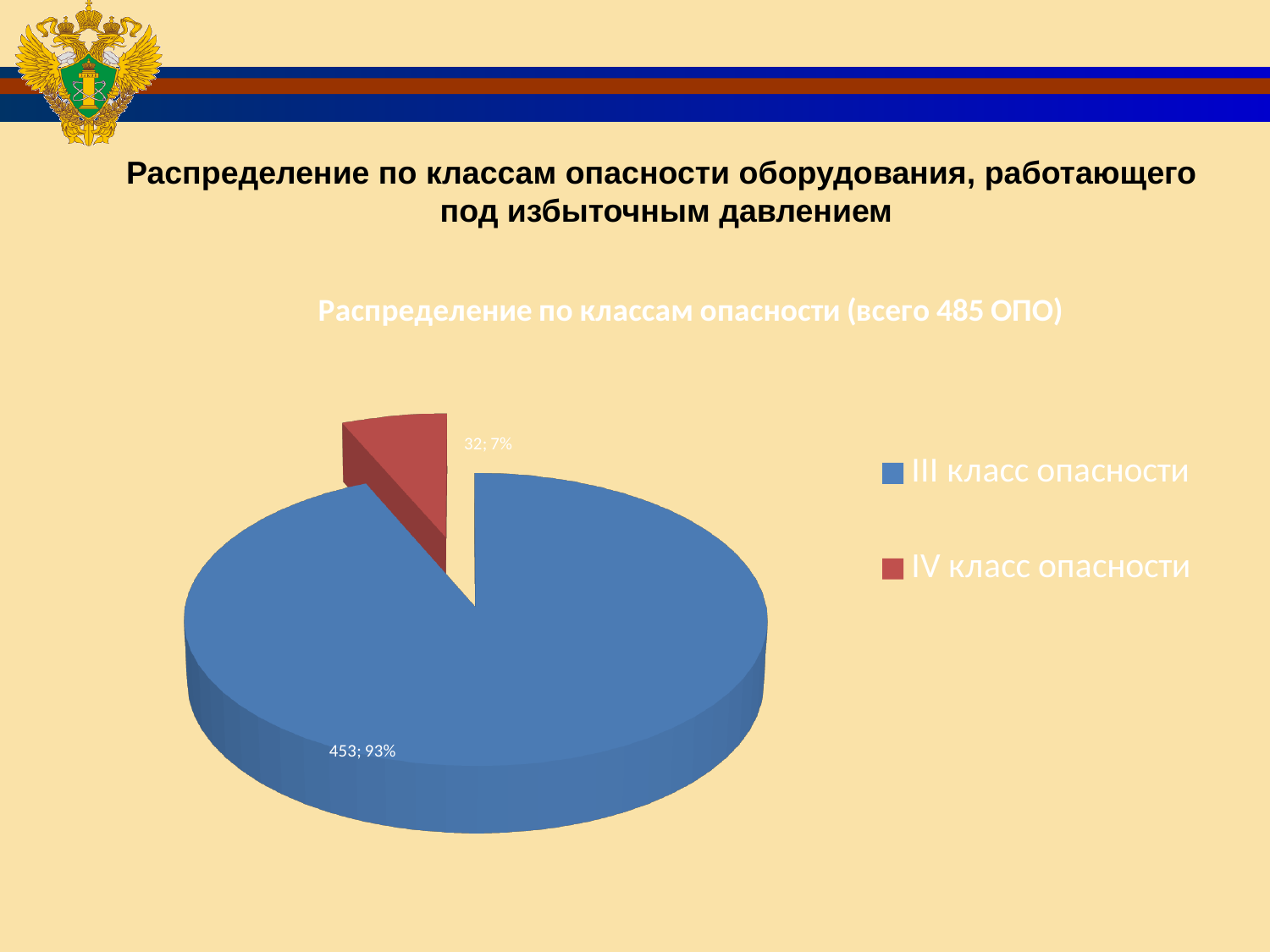
What is the value for IV класс опасности? 32 What share of the pie does III класс опасности represent? 93% What share of the pie does IV класс опасности represent? 7% What is the difference between the values for III класс опасности and IV класс опасности? 421 Which is larger, the value for III класс опасности or IV класс опасности? III класс опасности What colour is the slice for IV класс опасности? red What kind of chart is shown on the slide? pie chart Which category has the largest slice? III класс опасности How many categories does the pie chart have? 2 What is the title of the chart? Распределение по классам опасности (всего 485 ОПО) Which category has the smallest slice? IV класс опасности What is the value for III класс опасности? 453